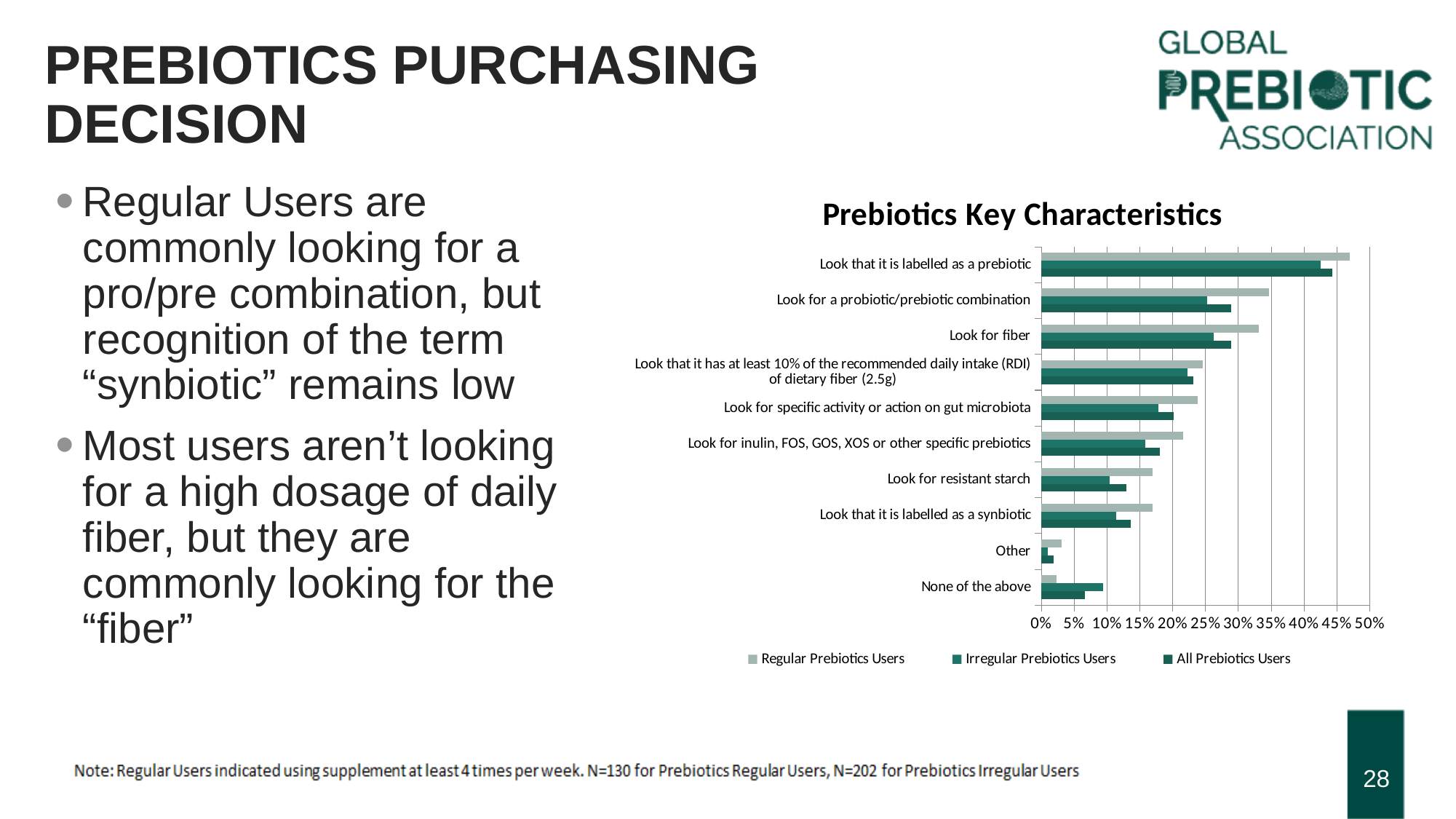
What is the title of the chart on the slide? Prebiotics Key Characteristics Is the value for All Prebiotics Users for 'Look for resistant starch' greater or less than 15%? less Is the value for Regular Prebiotics Users for 'Look that it is labelled as a prebiotic' greater or less than 45%? greater Which category has the highest value for Regular Prebiotics Users? Look that it is labelled as a prebiotic Is the value for Irregular Prebiotics Users for 'Look for a probiotic/prebiotic combination' greater or less than 30%? less For 'Look for fiber', which is larger: Regular Prebiotics Users or Irregular Prebiotics Users? Regular Prebiotics Users How many series does the legend of the Prebiotics Key Characteristics chart list? 3 Which category has the lowest value for Irregular Prebiotics Users? Other For 'None of the above', which is larger: Regular Prebiotics Users or Irregular Prebiotics Users? Irregular Prebiotics Users How many categories are plotted in the Prebiotics Key Characteristics chart? 10 What kind of chart is shown on the slide? bar chart